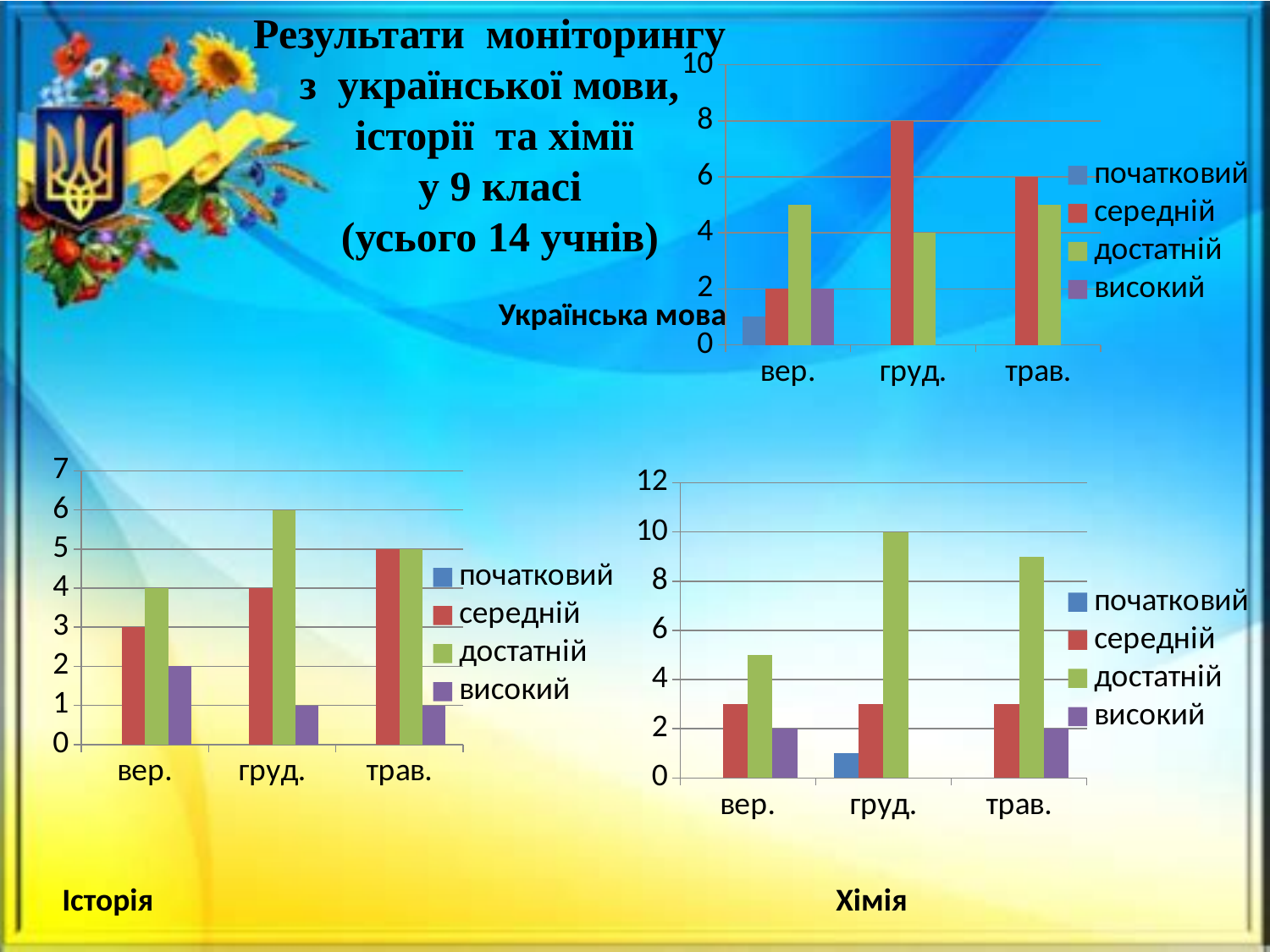
In the Історія chart, what is the value for середній in вер.? 3 What type of chart is the Історія chart? bar chart In the Історія chart, what is the difference between достатній and середній in вер.? 1 In the Українська мова chart, what is the value for достатній in груд.? 4 In the Історія chart, what is the value for достатній in груд.? 6 In the Хімія chart, what is the value for достатній in груд.? 10 How many series does the legend of the Хімія chart list? 4 In the Історія chart, what is the value for високий in трав.? 1 In the Хімія chart, which series has the highest bar in груд.? достатній In the Хімія chart, is the value for достатній in трав. greater or less than 8? greater In the Українська мова chart, what is the value for середній in груд.? 8 In the Українська мова chart, what is the value for середній in трав.? 6